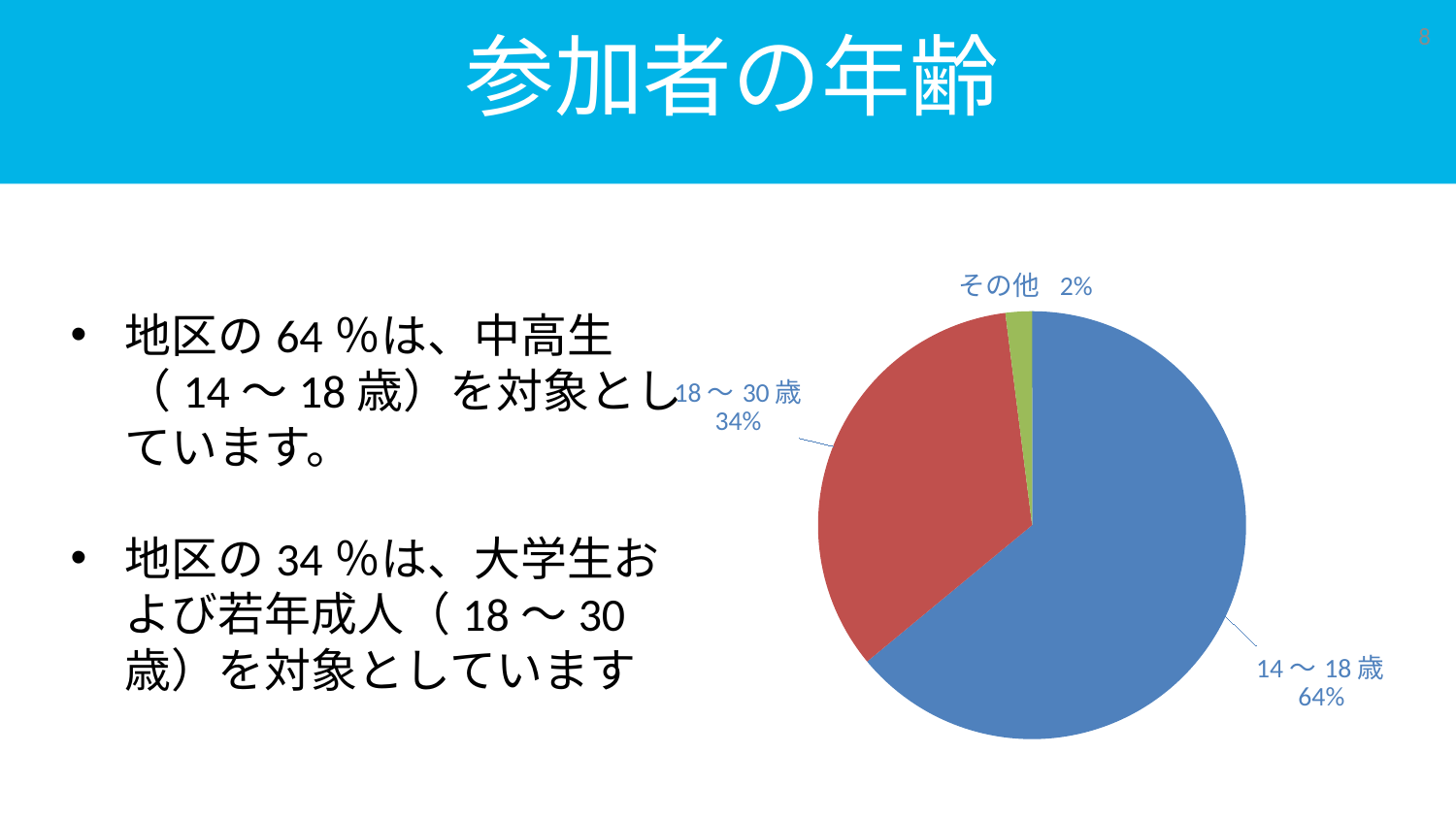
What share of the pie does the 18～30歳 slice represent? 34% What colour is the 14～18歳 slice? Blue What share of the pie does the その他 slice represent? 2% Which is larger, the 18～30歳 slice or the その他 slice? 18～30歳 What is the difference in percentage points between the 14～18歳 slice and the 18～30歳 slice? 30 How many slices does the pie chart have? 3 Which category has the smallest slice of the pie? その他 What kind of chart is shown on the slide? Pie chart What share of the pie does the 14～18歳 slice represent? 64% Which category has the largest slice of the pie? 14～18歳 What colour is the 18～30歳 slice? Red